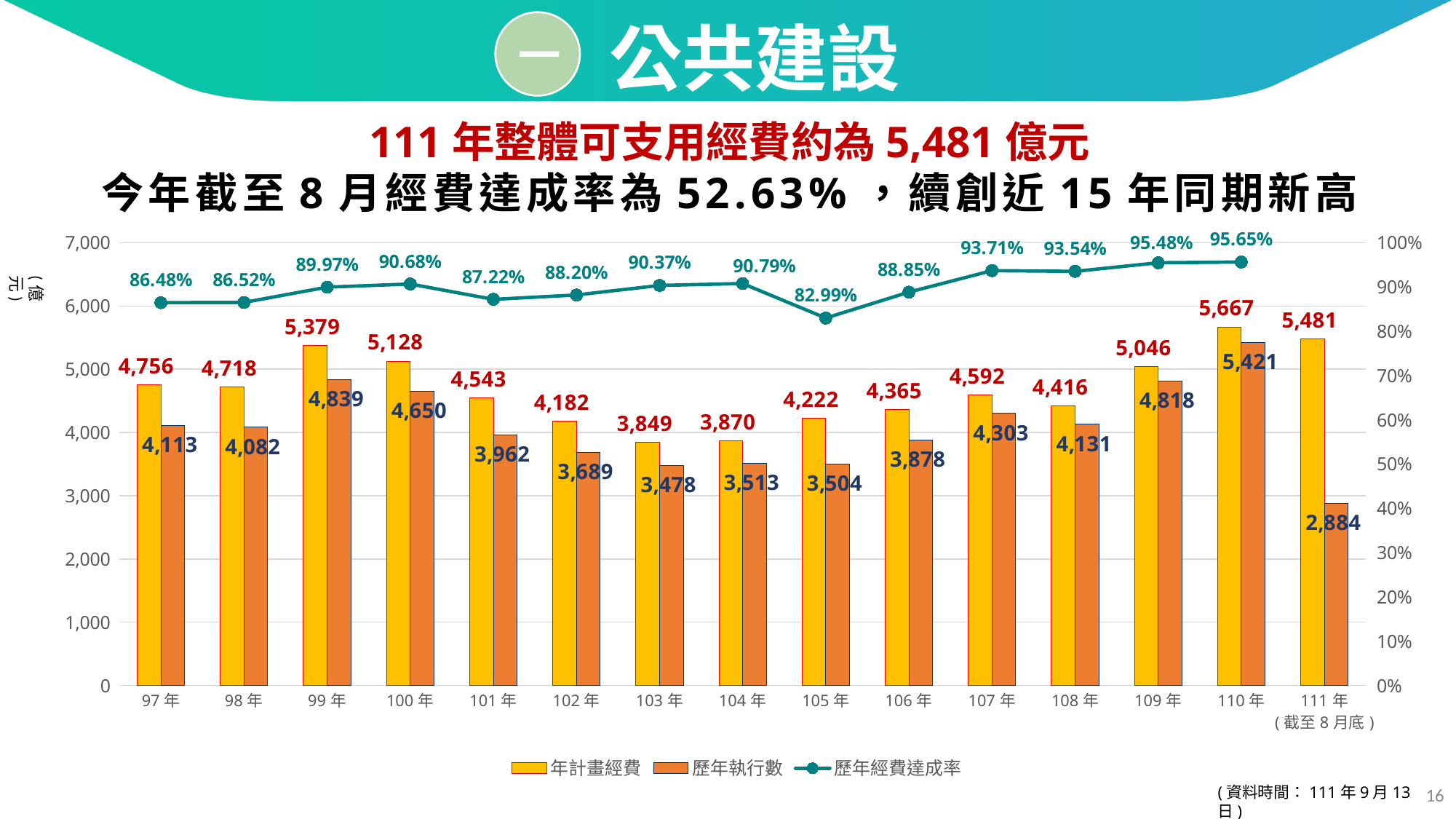
Which year has the lowest 歷年執行數? 111 年 What type of chart is shown on the slide? Combined bar and line chart What is the difference between 年計畫經費 and 歷年執行數 for 110 年? 246 Which year has the highest 年計畫經費? 110 年 How many series does the legend list? 3 What is the 年計畫經費 value for 111 年? 5,481 How many years are shown on the x axis? 15 What is the 歷年經費達成率 for 99 年? 89.97% What is the 歷年執行數 value for 105 年? 3,504 Does the 歷年經費達成率 line generally rise or fall from 105 年 to 110 年? Rise Which is larger, the 年計畫經費 for 99 年 or for 100 年? 99 年 Which year has the lowest 歷年經費達成率? 105 年